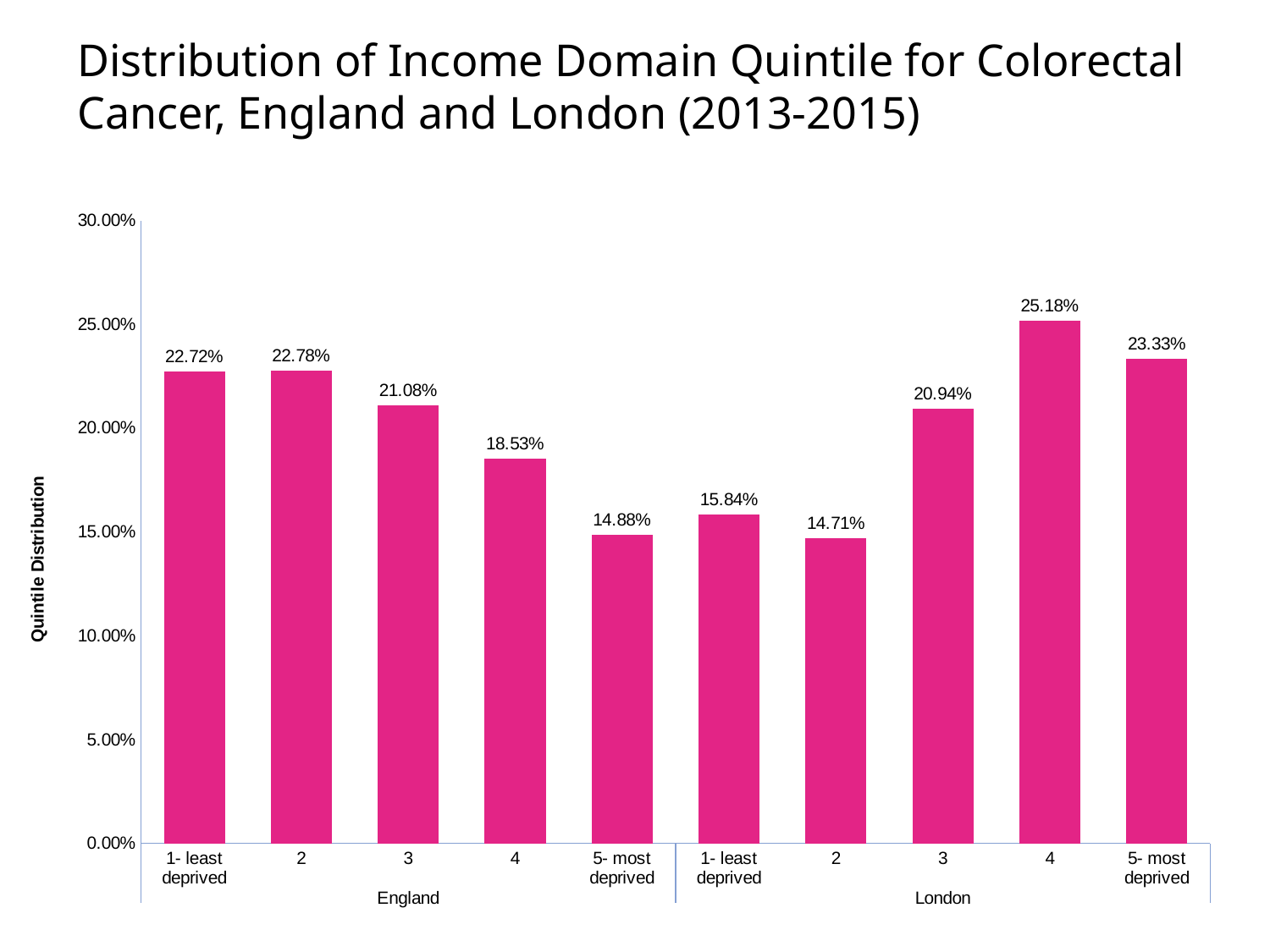
What is the value for quintile 4 in London? 25.18% Which bar has the highest value on the chart? London, 4 Which is larger: quintile 3 in England or quintile 3 in London? England What is the value for the '5- most deprived' quintile in England? 14.88% What is the label of the y axis? Quintile Distribution Do the values for England rise or fall from '1- least deprived' to '5- most deprived'? fall What kind of chart is shown? bar chart Which bar has the lowest value on the chart? London, 2 Is the value for quintile 4 in England greater or less than 20.00%? less How many bars are plotted on the chart? 10 What is the value for the '1- least deprived' quintile in London? 15.84% What is the difference between the '5- most deprived' values for London and England? 8.45%